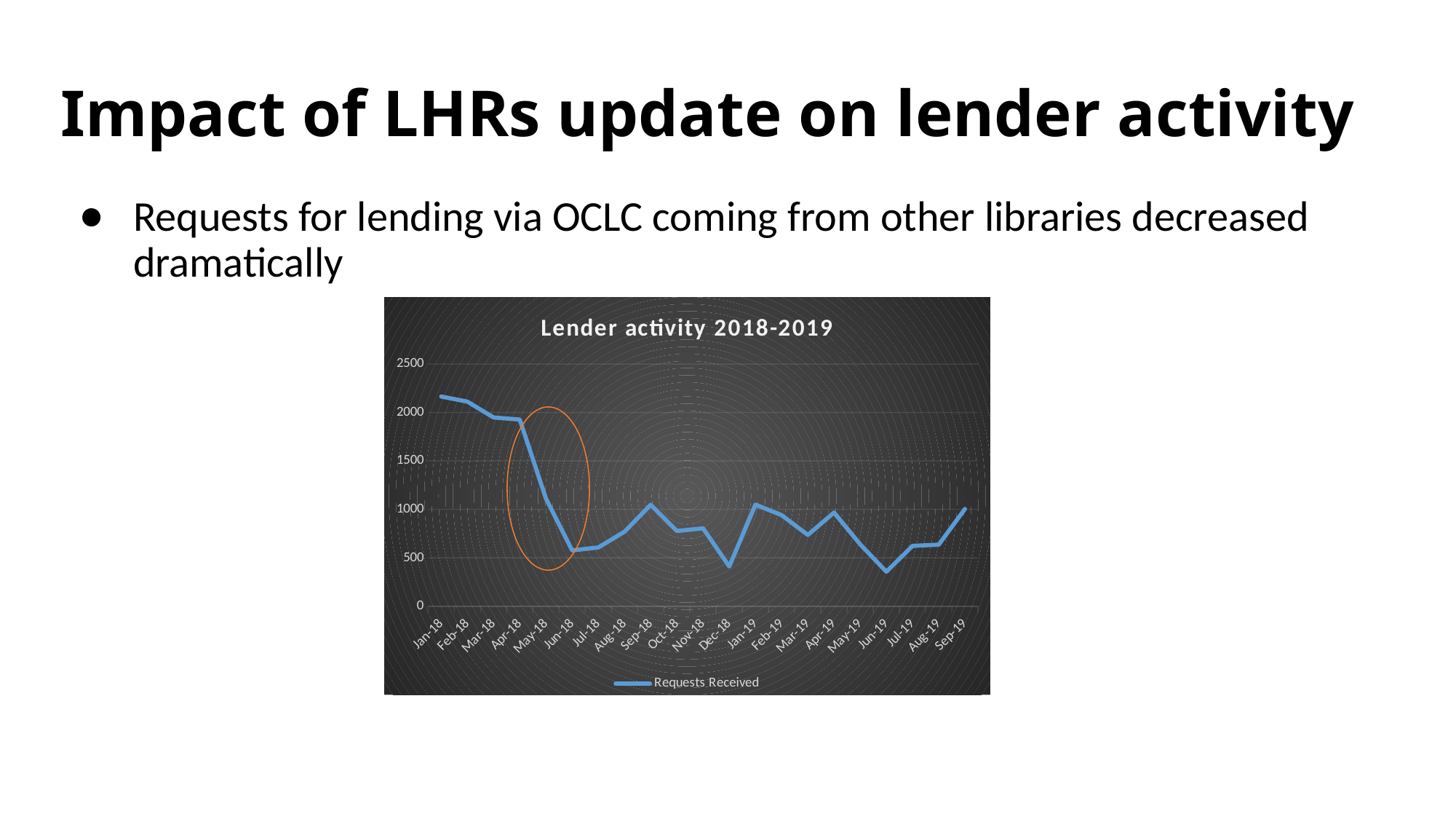
Is the value for Jan-18 greater or less than 2000? greater Which month has the highest number of requests received? Jan-18 Is the value for Dec-18 greater or less than 500? less Which is larger, the value for Apr-18 or the value for May-18? Apr-18 Do the values rise or fall from Jan-18 to Jun-18? fall What kind of chart is shown on the slide? line chart What is the name of the series shown in the legend? Requests Received What is the title of the chart? Lender activity 2018-2019 How many series does the chart's legend list? 1 Is the value for Jun-18 greater or less than 1000? less How many months are plotted along the x axis? 21